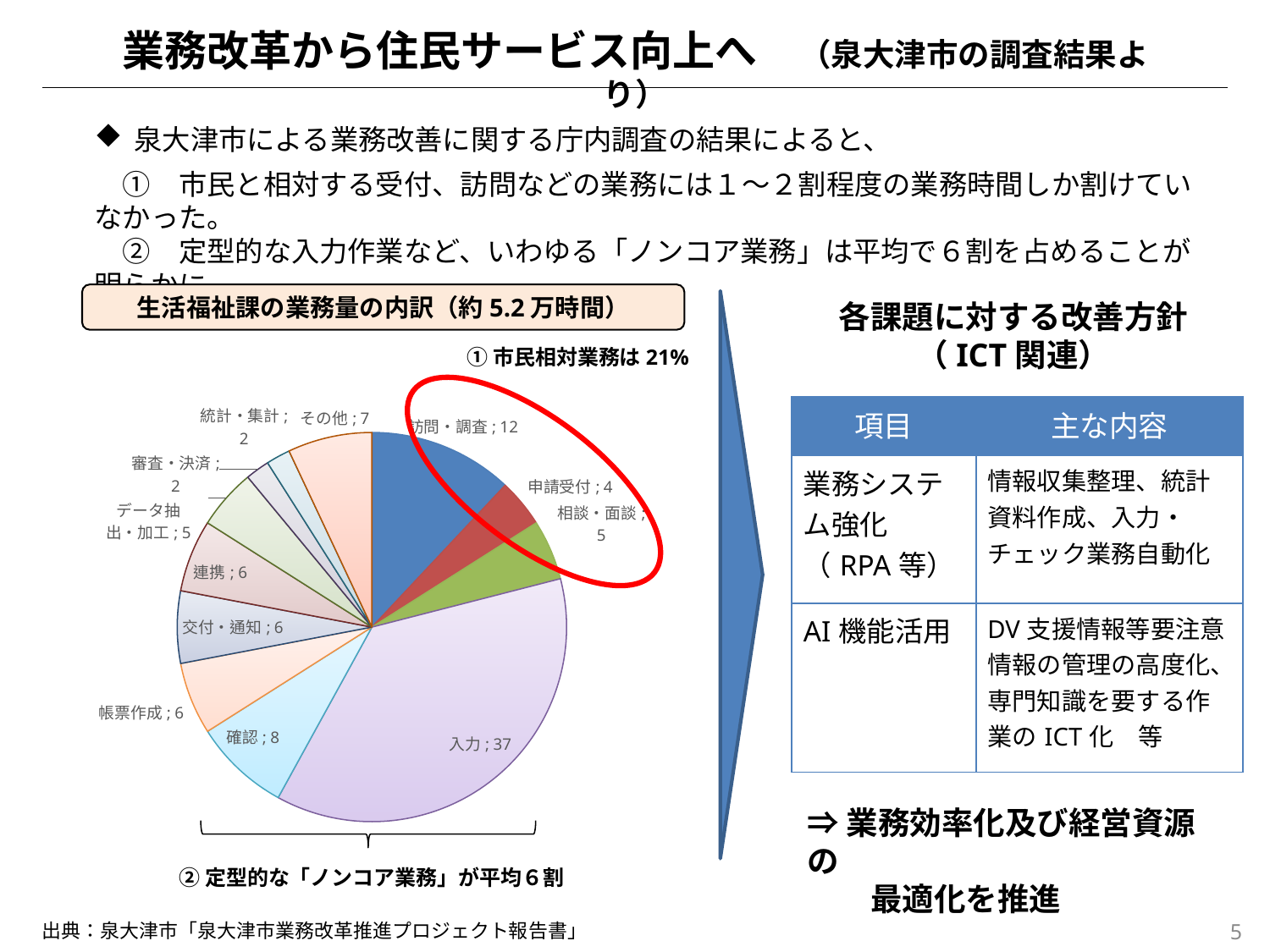
What is the title of the chart on the slide? 生活福祉課の業務量の内訳（約5.2万時間） Which category has the largest slice in the pie chart? 入力 How many categories (slices) does the pie chart have? 12 What type of chart is shown on the slide? pie chart What is the value for 訪問・調査 in the pie chart? 12 According to the annotation on the chart, what percentage of work is 市民相対業務? 21% What is the value for 入力 in the pie chart? 37 What is the value for 申請受付 in the pie chart? 4 What is the difference between the values for 相談・面談 and 申請受付? 1 What is the value for 確認 in the pie chart? 8 Which is larger in the pie chart, 確認 or 帳票作成? 確認 What is the difference between the values for 入力 and 訪問・調査? 25